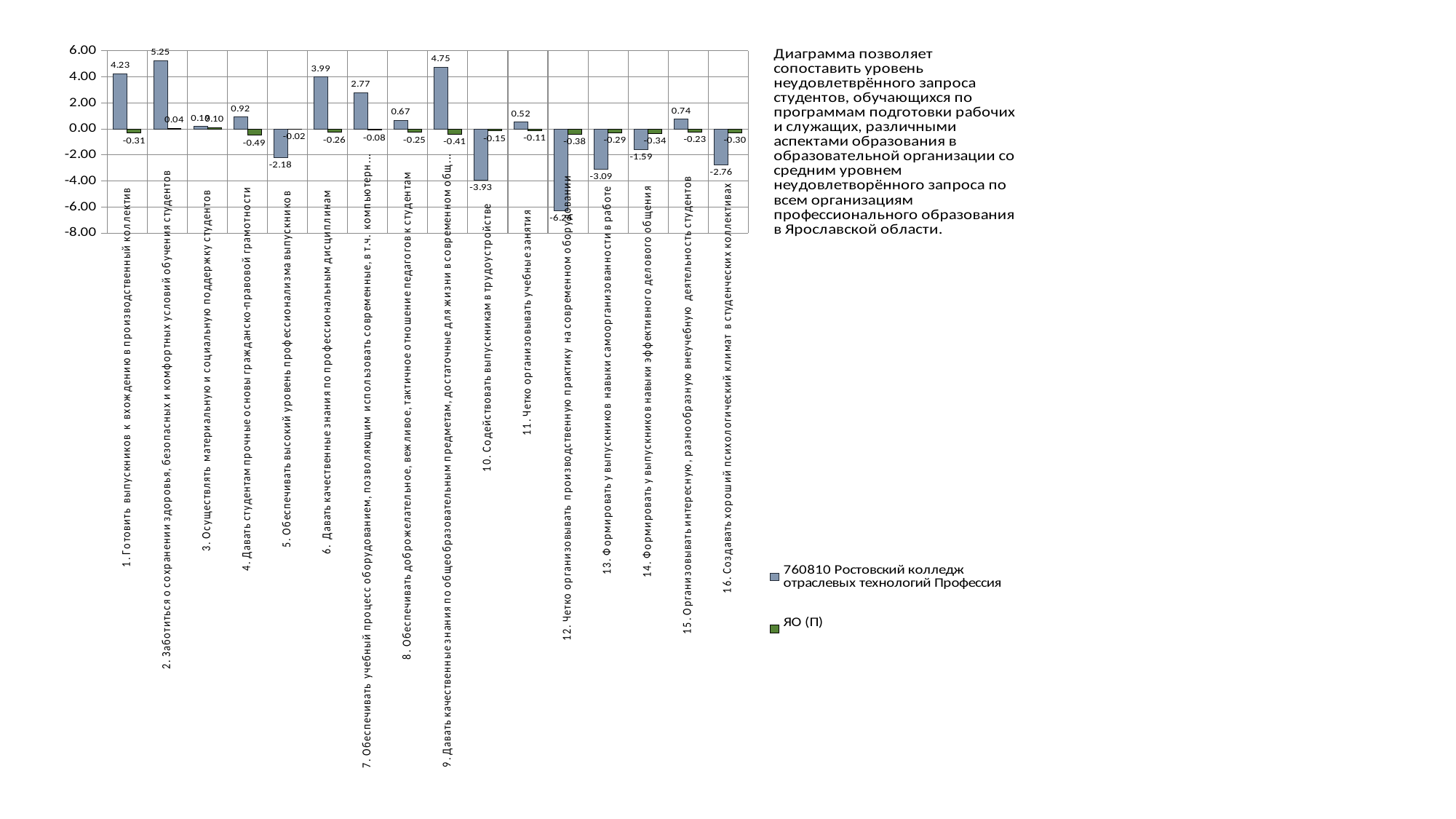
How many categories are plotted on the x axis? 16 What colour are the bars for the series "ЯО (П)"? green Which category has the lowest value for the series "760810 Ростовский колледж отраслевых технологий Профессия"? 12. Четко организовывать производственную практику на современном оборудовании What is the difference between the "760810 Ростовский колледж отраслевых технологий Профессия" values for category 1 (4.23) and category 6 (3.99)? 0.24 What kind of chart is shown on the slide? bar chart What is the value for the series "760810 Ростовский колледж отраслевых технологий Профессия" for category "10. Содействовать выпускникам в трудоустройстве"? -3.93 Which is larger for the series "760810 Ростовский колледж отраслевых технологий Профессия": the value for category "9. Давать качественные знания по общеобразовательным предметам..." or for category "7. Обеспечивать учебный процесс оборудованием..."? 9. Давать качественные знания по общеобразовательным предметам... How many series does the legend list? 2 Is the value for the series "760810 Ростовский колледж отраслевых технологий Профессия" for category 12 greater or less than -4.00? less What is the value for the series "760810 Ростовский колледж отраслевых технологий Профессия" for category "2. Заботиться о сохранении здоровья, безопасных и комфортных условий обучения студентов"? 5.25 Which category has the highest value for the series "760810 Ростовский колледж отраслевых технологий Профессия"? 2. Заботиться о сохранении здоровья, безопасных и комфортных условий обучения студентов What is the value for the series "ЯО (П)" for category "4. Давать студентам прочные основы гражданско-правовой грамотности"? -0.49